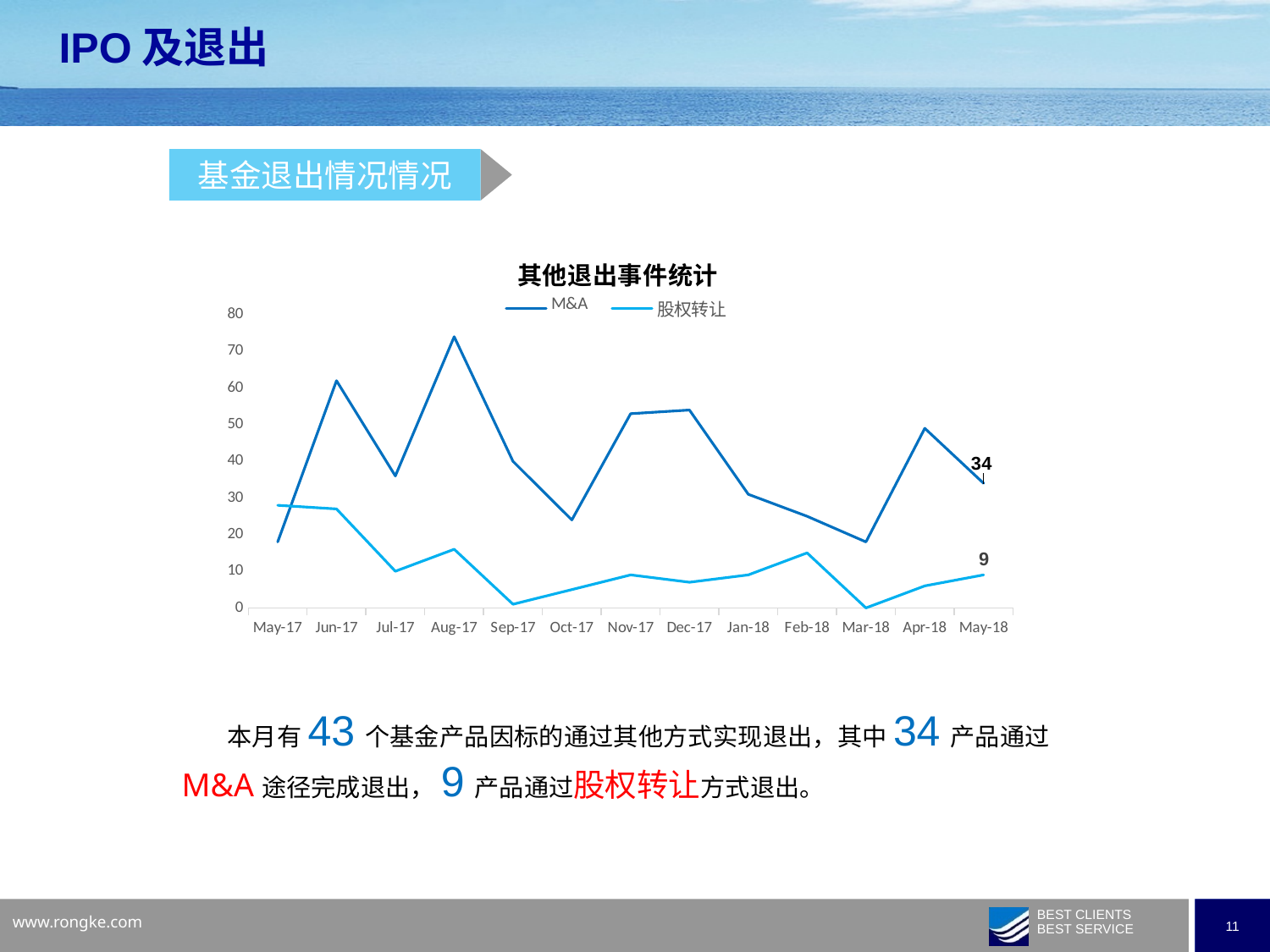
How many months are plotted on the x axis? 13 Is the M&A value for Aug-17 greater or less than 70? greater What is the difference between the M&A value and the 股权转让 value at May-18? 25 What kind of chart is shown on the slide? Line chart In which month does the M&A series reach its highest value? Aug-17 What is the value of the M&A series at May-18? 34 Is the M&A value for Oct-17 greater or less than 30? less Is the 股权转让 value for Sep-17 greater or less than 10? less How many series does the legend list? 2 At May-17, which series has the larger value, M&A or 股权转让? 股权转让 Does the M&A series rise or fall from Apr-18 to May-18? Fall What is the value of the 股权转让 series at May-18? 9